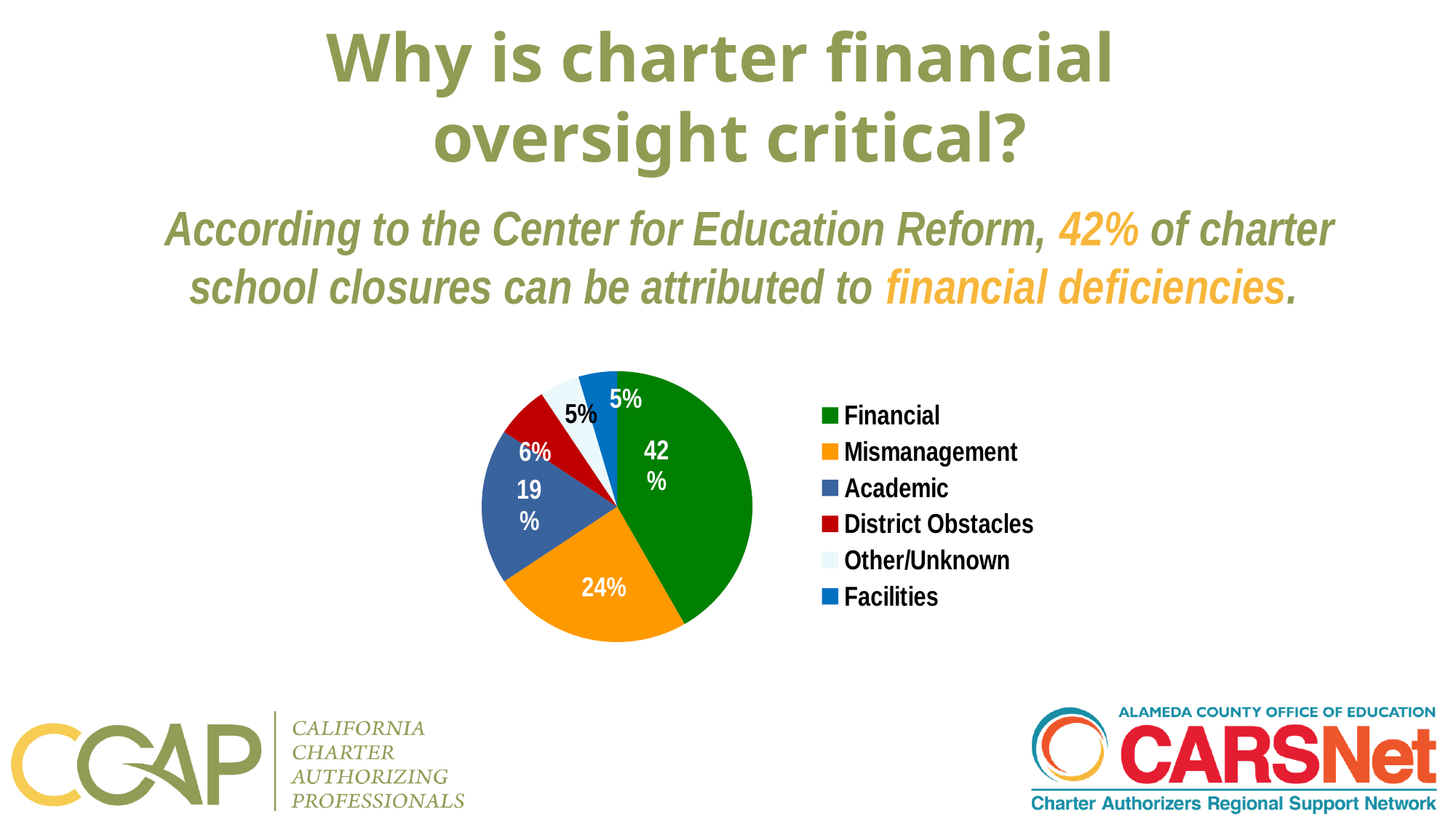
Which category has the largest slice of the pie? Financial What is the difference in percentage points between Financial and Mismanagement? 18 What percentage is shown for District Obstacles? 6% How many categories does the legend list? 6 What percentage is shown for Academic? 19% What kind of chart is shown on the slide? pie chart Which legend entry is shown in orange? Mismanagement Which is larger, the Academic slice or the District Obstacles slice? Academic What is the combined percentage of Other/Unknown and Facilities? 10% What percentage is shown for Mismanagement? 24% What colour is the Financial slice in the pie chart? green What share of the pie does the Financial slice represent? 42%